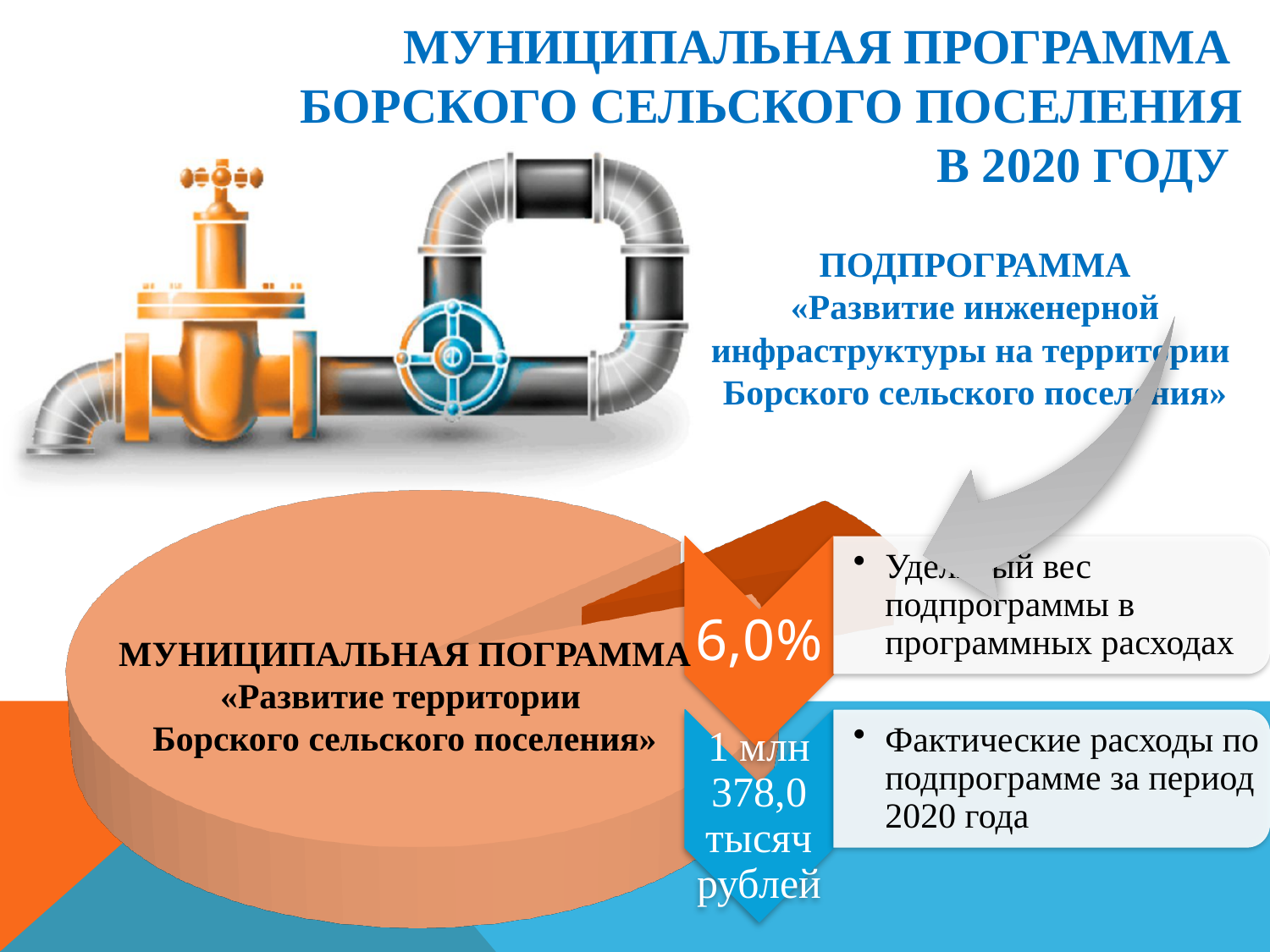
What label is printed on the large slice of the pie chart? МУНИЦИПАЛЬНАЯ ПОГРАММА «Развитие территории Борского сельского поселения» Which slice of the pie chart is the smallest? the 6,0% subprogram slice What share of the pie does the small exploded slice (the subprogram) represent? 6,0% Which slice of the pie chart is larger: the municipal program «Развитие территории Борского сельского поселения» slice or the 6,0% subprogram slice? the municipal program slice What are the actual expenses for the subprogram for 2020, as labelled next to the pie chart? 1 млн 378,0 тысяч рублей How many slices does the pie chart have? 2 What is the share of the subprogram «Развитие инженерной инфраструктуры на территории Борского сельского поселения» in the program expenses, as shown on the pie chart? 6,0% What kind of chart is shown on the slide? pie chart What colour is the large slice of the pie chart? orange